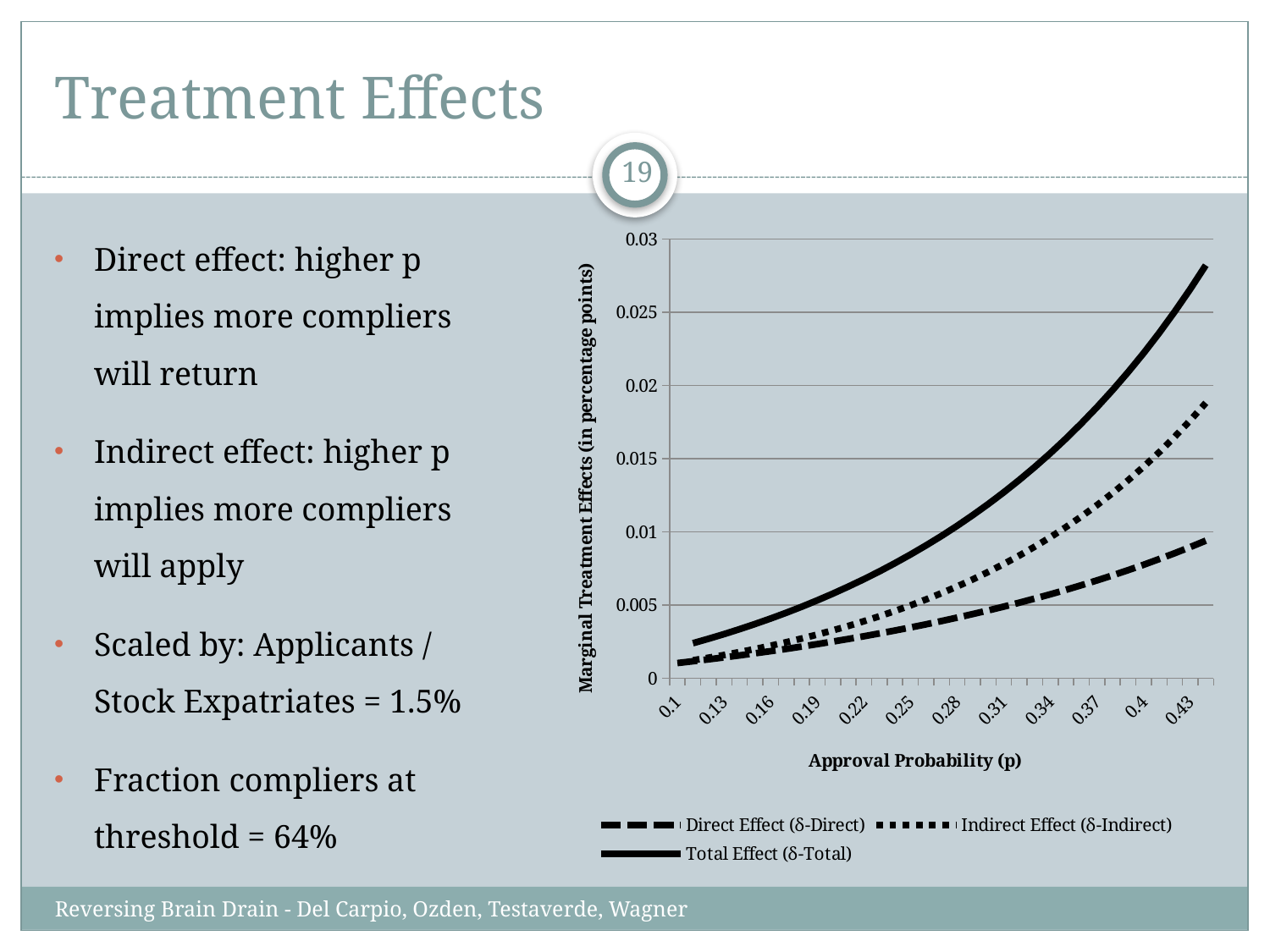
Does the Direct Effect (δ-Direct) line rise or fall as Approval Probability (p) increases? Rises Which series has the lowest value at p = 0.43? Direct Effect (δ-Direct) Is the value of the Total Effect (δ-Total) at p = 0.43 greater or less than 0.025? greater Is the value of the Indirect Effect (δ-Indirect) at p = 0.43 greater or less than 0.015? greater Does the Total Effect (δ-Total) line rise or fall as Approval Probability (p) increases? Rises Which series has the highest value at p = 0.43? Total Effect (δ-Total) At p = 0.43, which is larger: the Indirect Effect (δ-Indirect) or the Direct Effect (δ-Direct)? Indirect Effect (δ-Indirect) How many series does the chart's legend list? 3 Is the value of the Direct Effect (δ-Direct) at p = 0.43 greater or less than 0.01? less What kind of chart is shown on the slide? Line chart What is the title of the chart's vertical axis? Marginal Treatment Effects (in percentage points)